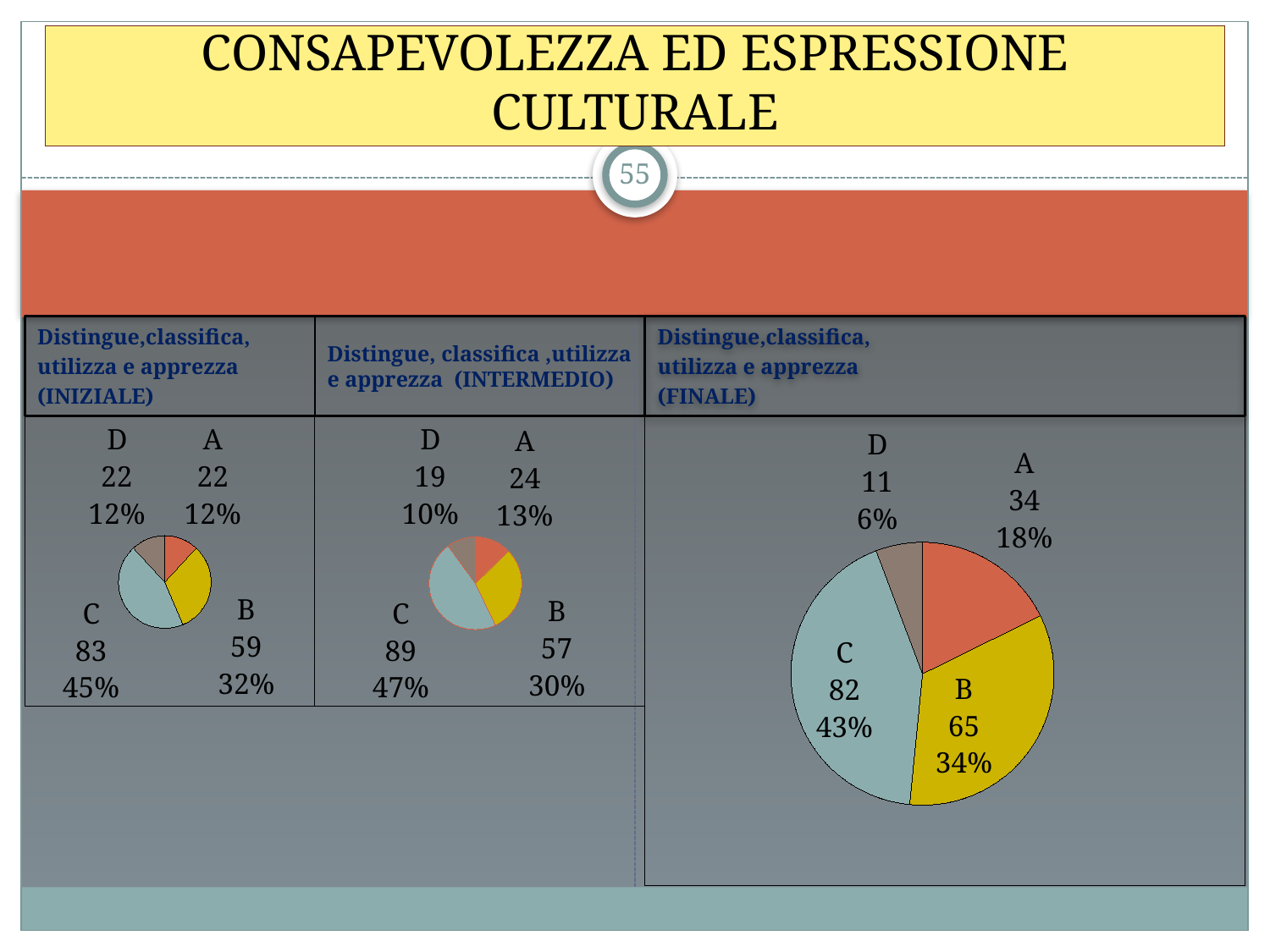
In the FINALE pie chart (right), which category has the highest value? C In the FINALE pie chart (right), which is larger, the value for A or the value for D? A In the FINALE pie chart (right), what is the difference between the values for C and B? 17 In the FINALE pie chart (right), what is the value for category B? 65 What kind of chart is used in the FINALE panel on the right? Pie chart In the INIZIALE pie chart (left), what share of the pie does category B represent? 32% In the INTERMEDIO pie chart (middle), which category has the lowest value? D In the INTERMEDIO pie chart (middle), what share of the pie does category C represent? 47% In the INIZIALE pie chart (left), what is the value for category C? 83 In the INTERMEDIO pie chart (middle), what is the value for category A? 24 How many categories does the INIZIALE pie chart (left) show? 4 In the FINALE pie chart (right), what share of the pie does category D represent? 6%